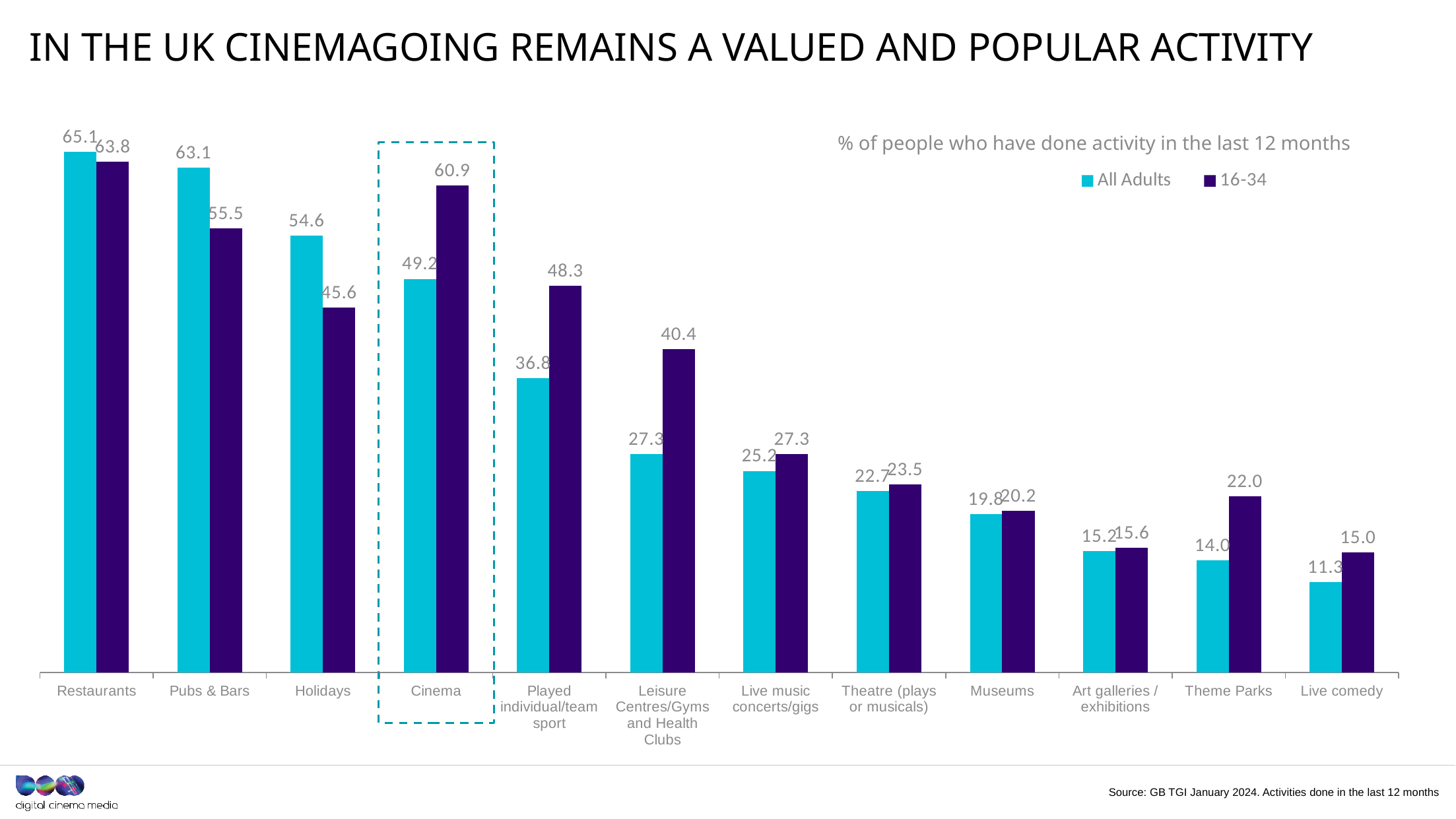
Which category has the lowest value in the All Adults series? Live comedy For Holidays, which series has the larger value, All Adults or 16-34? All Adults What is the value for Cinema in the All Adults series? 49.2 Which category is highlighted with a dashed outline box? Cinema What kind of chart is shown on the slide? Bar chart How many activity categories are shown on the x axis? 12 Which category has the highest value in the All Adults series? Restaurants Do the All Adults values rise or fall moving from left to right along the x axis? Fall What is the value for Cinema in the 16-34 series? 60.9 How many series does the legend list? 2 What is the difference between the 16-34 and All Adults values for Cinema? 11.7 What is the value for Theme Parks in the 16-34 series? 22.0